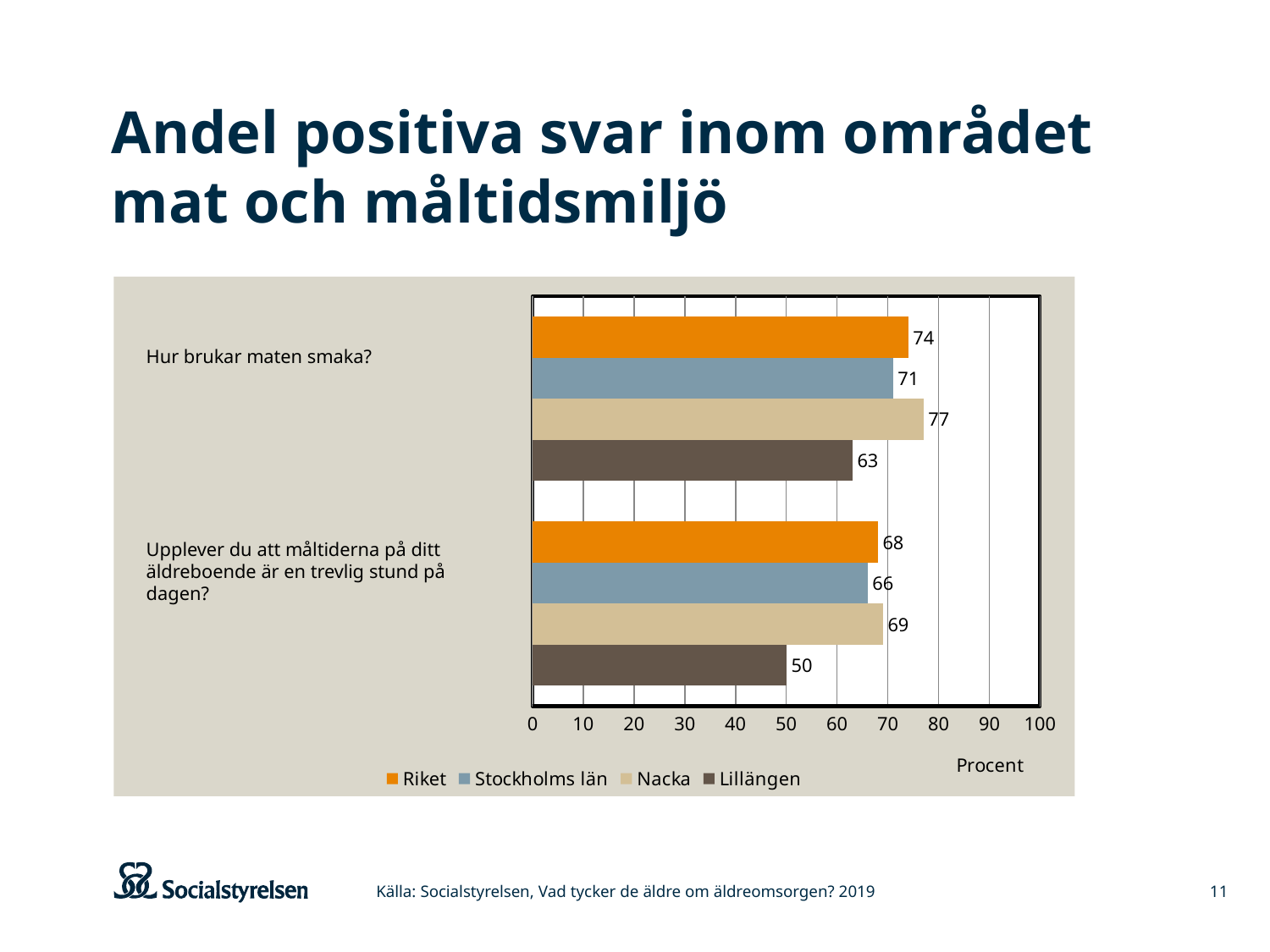
What kind of chart is shown on the slide? Bar chart What is the value for Riket on the question "Hur brukar maten smaka?"? 74 Which is larger: the Riket value for "Hur brukar maten smaka?" or the Riket value for "Upplever du att måltiderna på ditt äldreboende är en trevlig stund på dagen?"? Hur brukar maten smaka? What is the label of the horizontal axis? Procent What is the value for Nacka on the question "Hur brukar maten smaka?"? 77 What is the value for Stockholms län on the question "Upplever du att måltiderna på ditt äldreboende är en trevlig stund på dagen?"? 66 How many series does the legend list? 4 Which series has the lowest value for "Upplever du att måltiderna på ditt äldreboende är en trevlig stund på dagen?"? Lillängen What is the difference between the Nacka and Lillängen values for "Hur brukar maten smaka?"? 14 What is the value for Lillängen on the question "Upplever du att måltiderna på ditt äldreboende är en trevlig stund på dagen?"? 50 What is the difference between the Riket and Stockholms län values for "Upplever du att måltiderna på ditt äldreboende är en trevlig stund på dagen?"? 2 Which series has the highest value for "Hur brukar maten smaka?"? Nacka